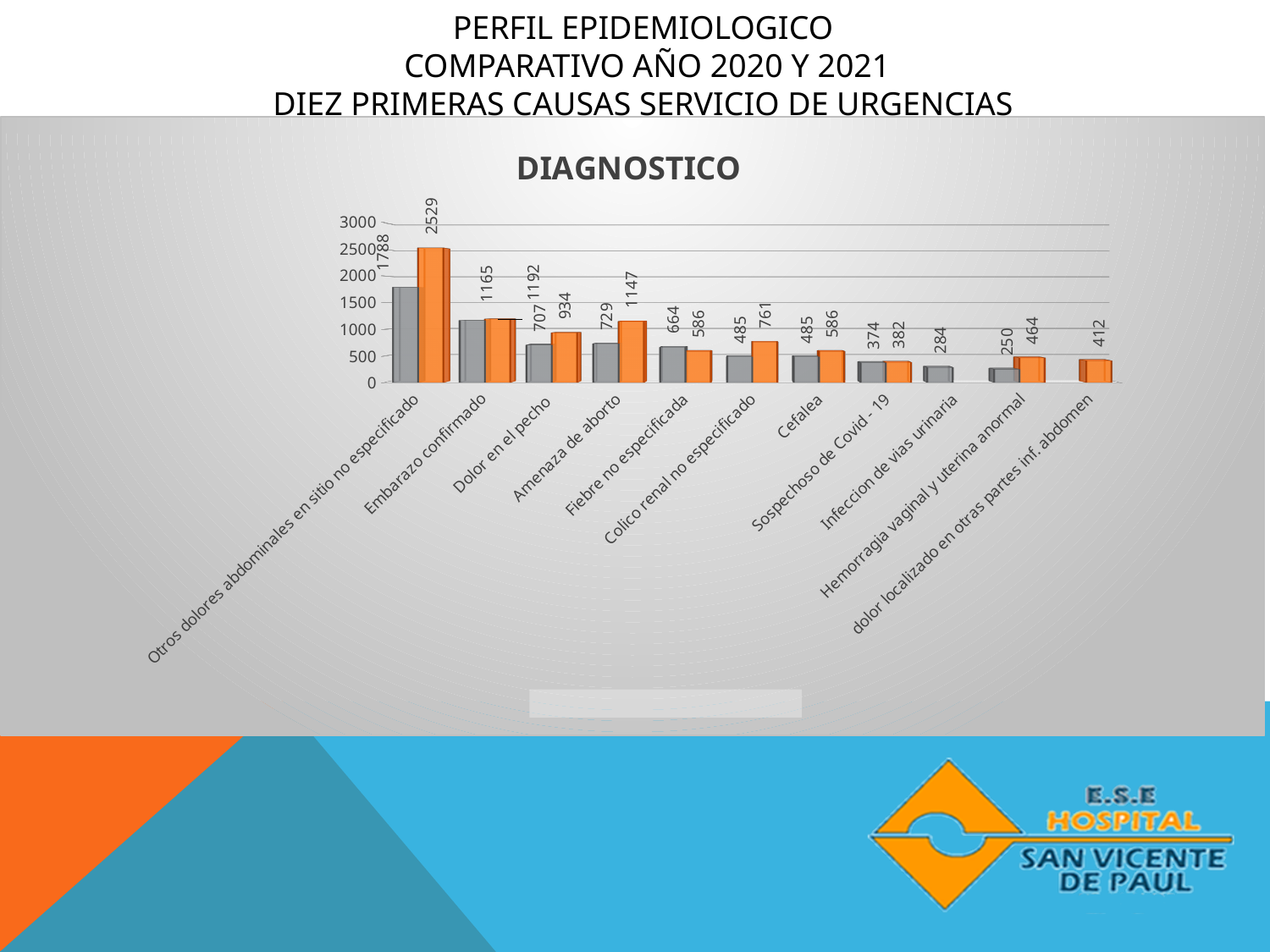
Which category has the highest orange bar? Otros dolores abdominales en sitio no especificado What is the value of the gray bar for 'Embarazo confirmado'? 1165 What is the value of the orange bar for 'Otros dolores abdominales en sitio no especificado'? 2529 For 'Fiebre no especificada', which bar is larger, the gray or the orange? gray For 'Amenaza de aborto', which bar is larger, the gray or the orange? orange What is the difference between the orange and gray bars for 'Otros dolores abdominales en sitio no especificado'? 741 Which category has the lowest gray bar among those with a gray bar? Hemorragia vaginal y uterina anormal What kind of chart is shown on the slide? bar chart What is the value of the gray bar for 'Infeccion de vias urinaria'? 284 What is the title of the chart? DIAGNOSTICO How many diagnosis categories are shown on the x axis? 11 What is the value of the orange bar for 'Amenaza de aborto'? 1147